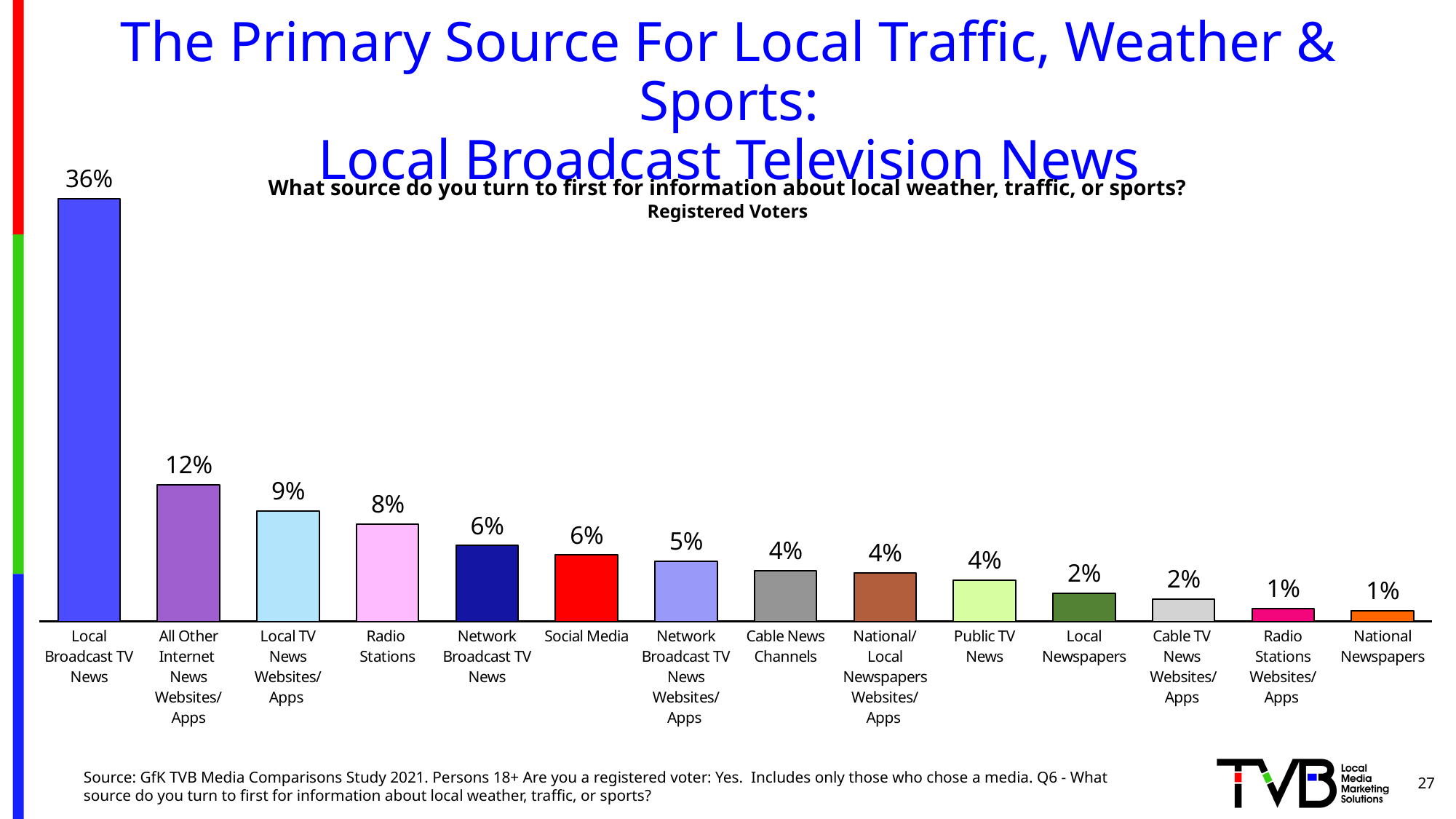
What is the difference between the values for Local TV News Websites/Apps and Cable TV News Websites/Apps? 7% Which source has the highest value on the chart? Local Broadcast TV News Which is larger, the value for Radio Stations or the value for Network Broadcast TV News? Radio Stations What is the value shown for Radio Stations? 8% Which group of respondents does the chart describe, according to the subtitle? Registered Voters How many sources (categories) are shown on the chart? 14 What percentage of registered voters turn first to Local Broadcast TV News for local weather, traffic, or sports? 36% What kind of chart is shown on the slide? Bar chart Do the values rise or fall moving from left to right along the x axis? Fall What is the value shown for Local Newspapers? 2% What is the value shown for Social Media? 6% What is the difference between the values for Local Broadcast TV News and All Other Internet News Websites/Apps? 24%